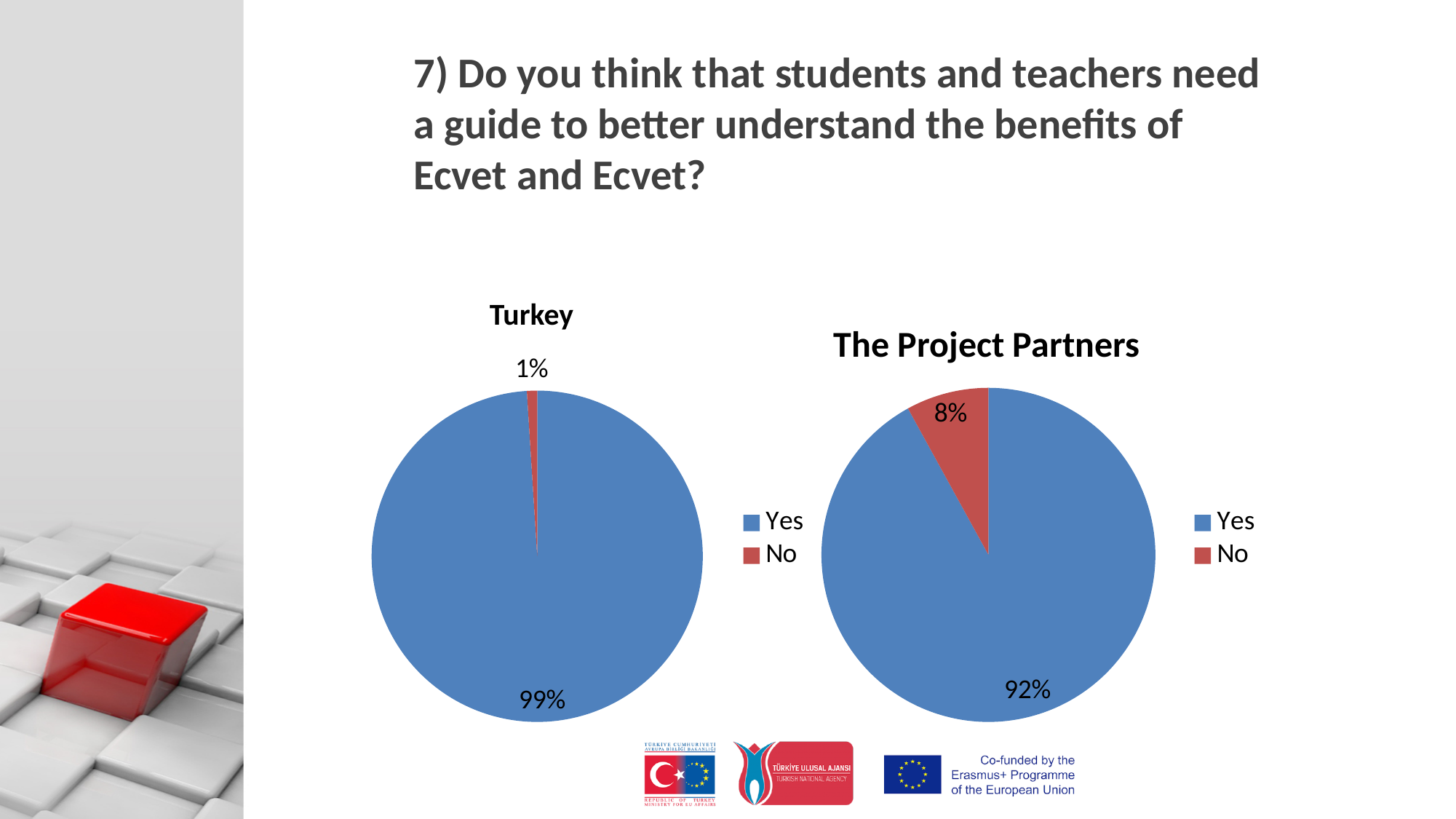
How many slices does the Turkey pie chart have? 2 In The Project Partners chart, what is the difference between the Yes and No percentages? 84% In the Turkey chart, what percentage answered Yes? 99% In the Turkey chart, which response has the largest slice? Yes Is the No share larger in the Turkey chart or in The Project Partners chart? The Project Partners What type of chart is the Turkey chart? Pie chart In the Turkey chart, what percentage answered No? 1% In The Project Partners chart, which response has the smallest slice? No In The Project Partners chart, what percentage answered No? 8% In the Turkey chart, what colour represents the No slice? Red How many categories does the legend of The Project Partners chart list? 2 In The Project Partners chart, what percentage answered Yes? 92%